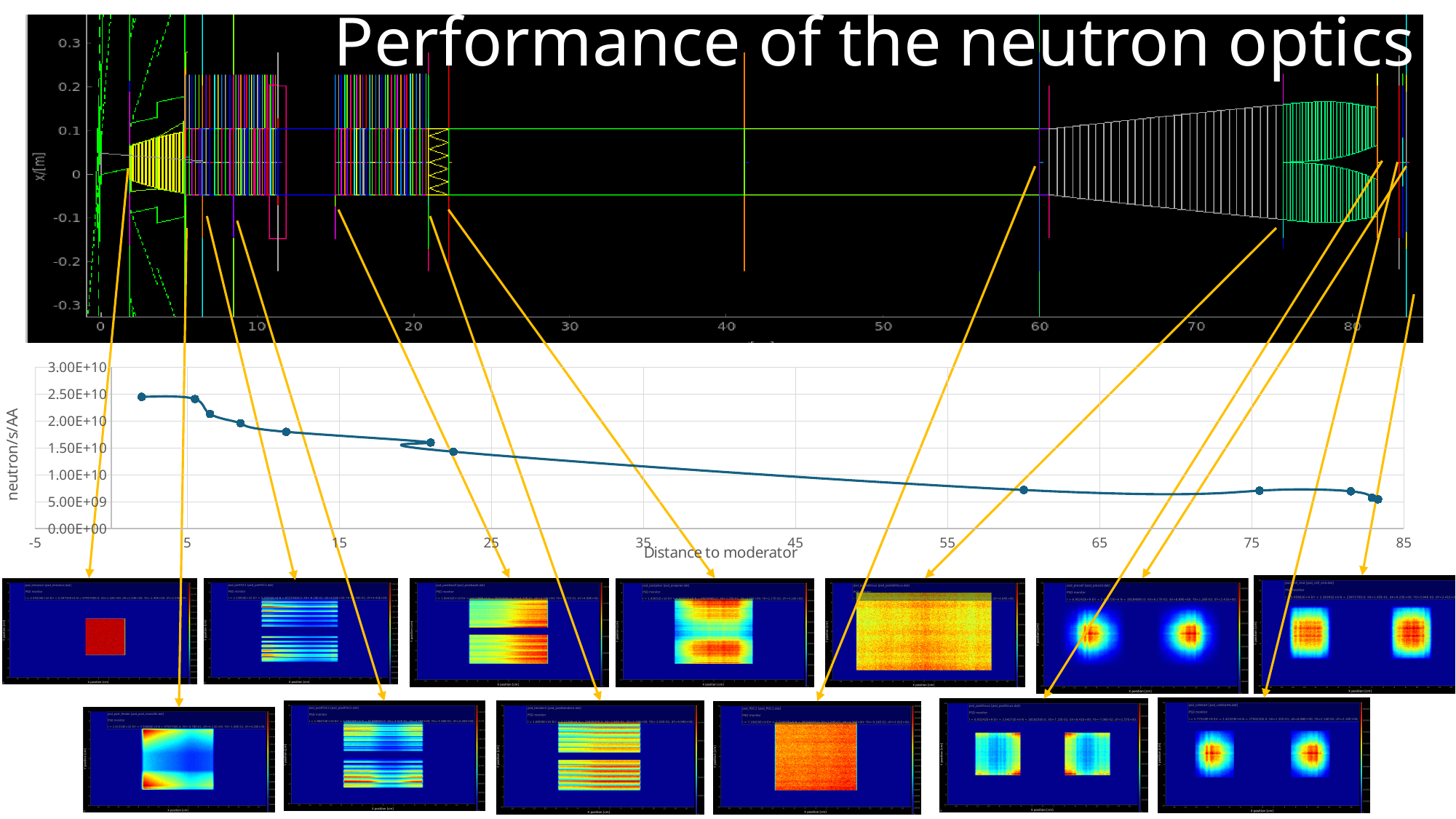
In the neutron/s/AA chart, is the value at the last data point (near distance 83) greater or less than 1.00E+10? less In the neutron/s/AA chart, is the value at the first data point (near distance 2) greater or less than 2.00E+10? greater What is the label of the x axis of the line chart? Distance to moderator What is the label of the y axis of the line chart? neutron/s/AA What is the title of the slide? Performance of the neutron optics In the neutron/s/AA chart, do the values generally rise or fall as the distance to moderator increases? fall What kind of chart is the neutron/s/AA versus Distance to moderator chart? line chart In the neutron/s/AA chart, at roughly which end of the x axis is the highest value found, the low-distance end or the high-distance end? the low-distance end In the neutron/s/AA chart, is the value at the data point near distance 60 greater or less than 1.00E+10? less What is the highest tick value shown on the y axis of the line chart? 3.00E+10 In the neutron/s/AA chart, which is larger: the value near distance 5 or the value near distance 75? the value near distance 5